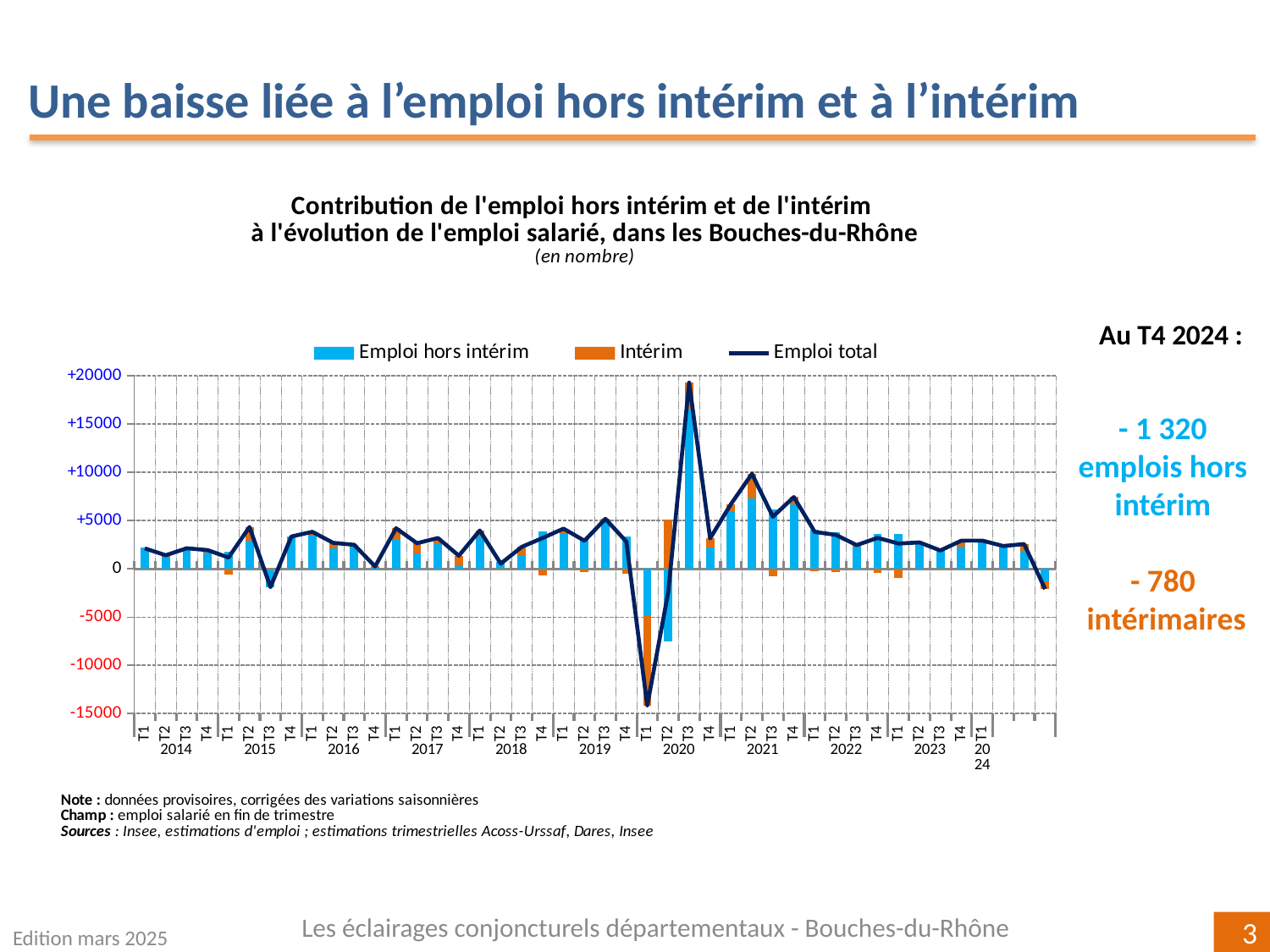
In which quarter does the Emploi total line reach its highest value? T3 2020 Is the value of Emploi total at T1 2020 greater or less than -10000? less What is the title of the chart? Contribution de l'emploi hors intérim et de l'intérim à l'évolution de l'emploi salarié, dans les Bouches-du-Rhône Which is larger, the Emploi total value at T3 2020 or at T2 2021? T3 2020 Is the value of Emploi total at T3 2020 greater or less than 15000? greater Between T3 2020 and T4 2020, does the Emploi total line rise or fall? fall How many series does the chart legend list? 3 What is the value for Intérim at T4 2024? - 780 What is the value for Emploi hors intérim at T4 2024? - 1 320 What kind of chart is shown on the slide? A combined bar and line chart In which quarter does the Emploi total line reach its lowest value? T1 2020 What is the total of the stacked bar (Emploi hors intérim plus Intérim) at T4 2024? -2 100